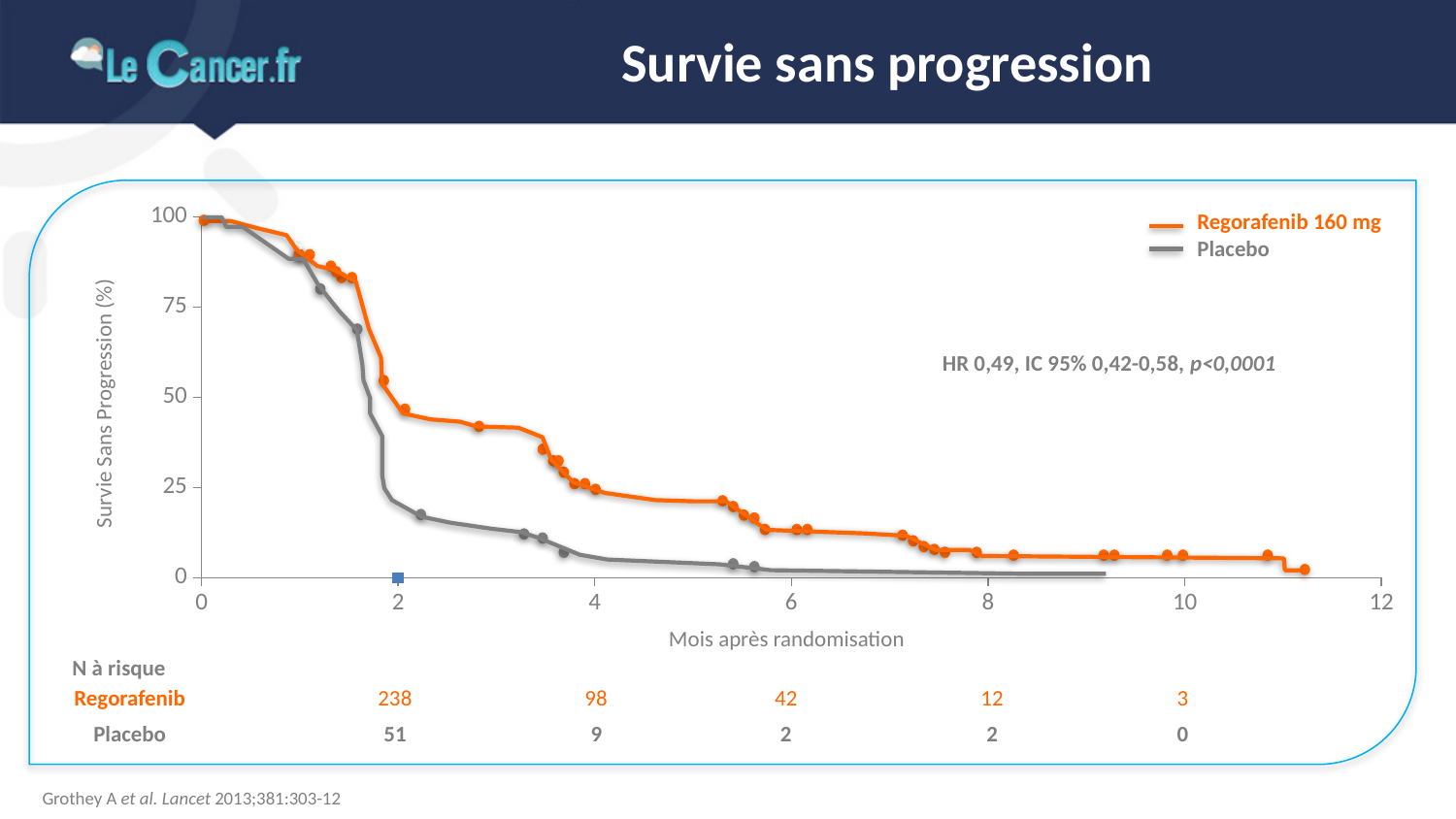
Is the Regorafenib 160 mg progression-free survival at 2 months greater or less than 50? less What is the label of the y axis? Survie Sans Progression (%) What kind of chart is shown on the slide? line chart How many series does the legend list? 2 In the 'N à risque' table, how many Regorafenib patients are at risk at 2 months? 238 In the 'N à risque' table, how many Placebo patients are at risk at 4 months? 9 Is the Regorafenib 160 mg progression-free survival at 6 months greater or less than 25? less Do the survival curves rise or fall as months after randomisation increase? fall What are the two series named in the legend? Regorafenib 160 mg and Placebo Is the Placebo progression-free survival at 4 months greater or less than 25? less At 4 months after randomisation, which curve is higher, Regorafenib 160 mg or Placebo? Regorafenib 160 mg What is the difference between the number of Regorafenib and Placebo patients at risk at 2 months? 187